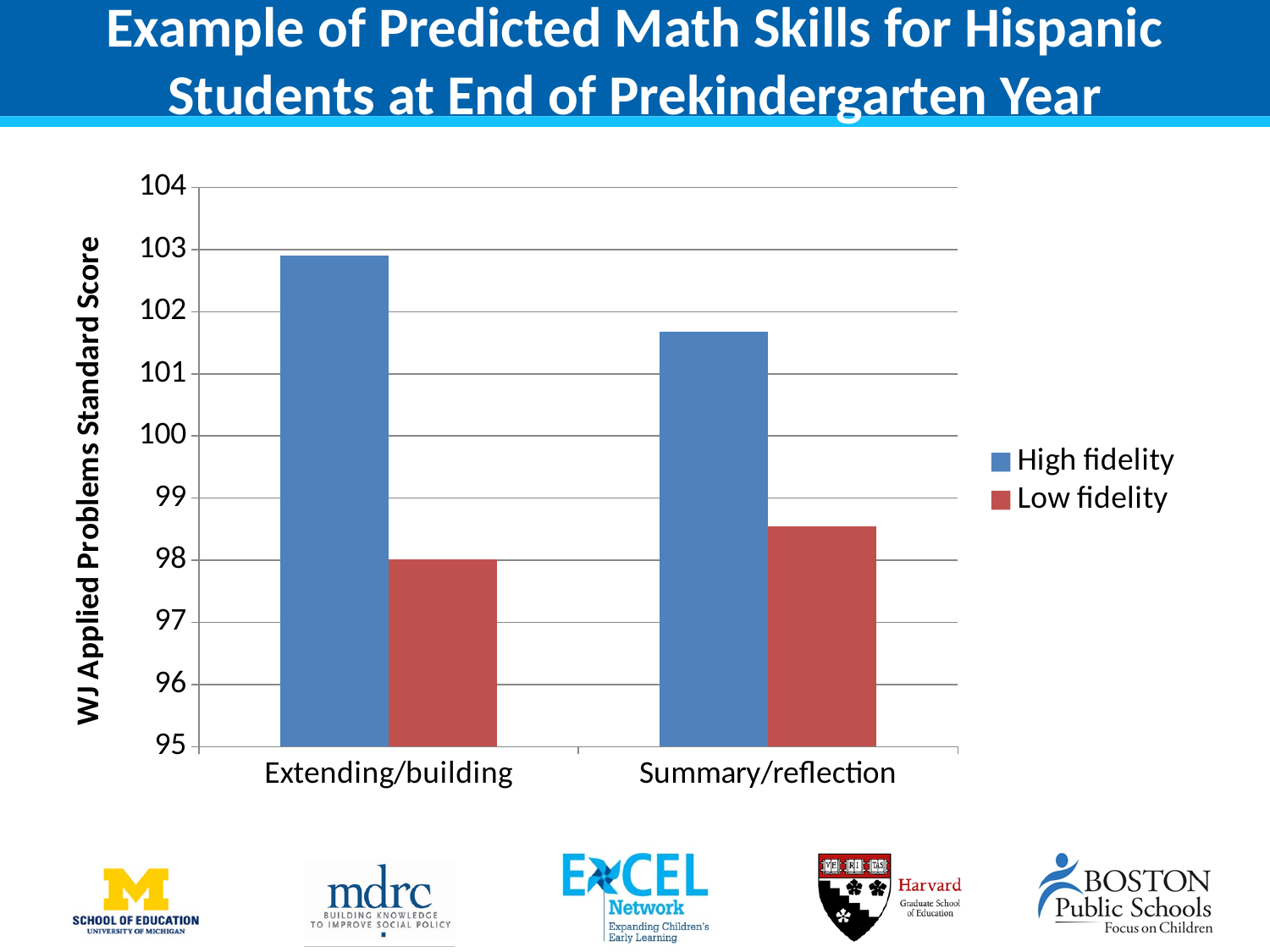
What kind of chart is shown on the slide? Bar chart Is the Low fidelity value for Summary/reflection greater or less than 98? greater Is the Low fidelity value for Extending/building greater or less than 99? less How many series does the legend list? 2 Does the High fidelity series rise or fall from Extending/building to Summary/reflection? fall How many categories are shown on the x axis? 2 Which series is shown in blue? High fidelity For Summary/reflection, which is larger: High fidelity or Low fidelity? High fidelity What is the y-axis label of the chart? WJ Applied Problems Standard Score Is the High fidelity value for Summary/reflection greater or less than 102? less Which bar is the tallest in the chart? High fidelity, Extending/building